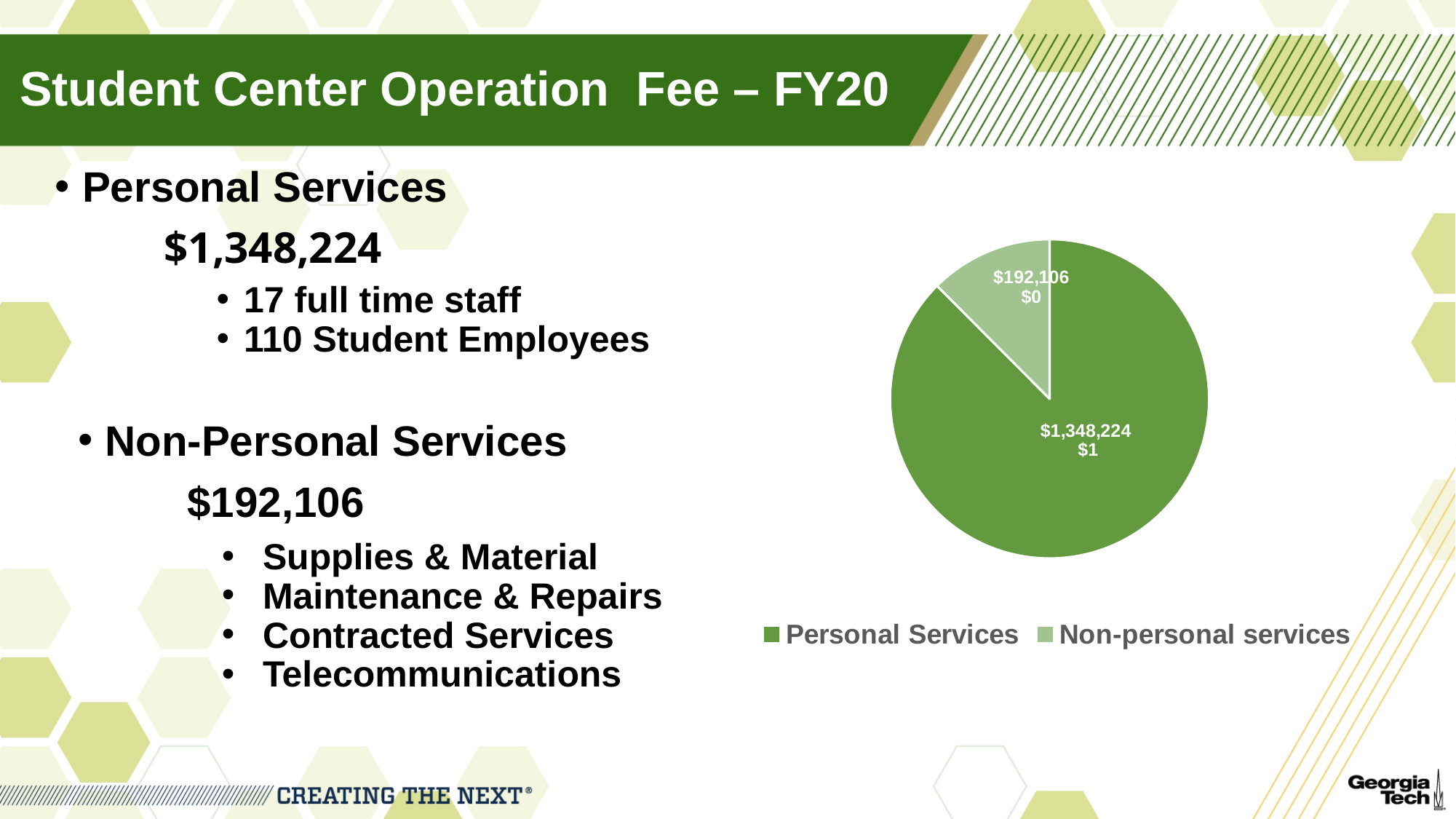
What is the difference between the Personal Services value and the Non-personal services value in the pie chart? $1,156,118 Which legend entry is shown in the lighter green colour? Non-personal services Which slice of the pie chart is the largest? Personal Services Which slice of the pie chart is the smallest? Non-personal services What is the value shown for Non-personal services in the pie chart? $192,106 What kind of chart is shown on the slide? Pie chart What is the value shown for Personal Services in the pie chart? $1,348,224 How many slices does the pie chart have? 2 Which is larger in the pie chart, Personal Services or Non-personal services? Personal Services How many entries does the pie chart legend list? 2 What is the total of the two slices in the pie chart? $1,540,330